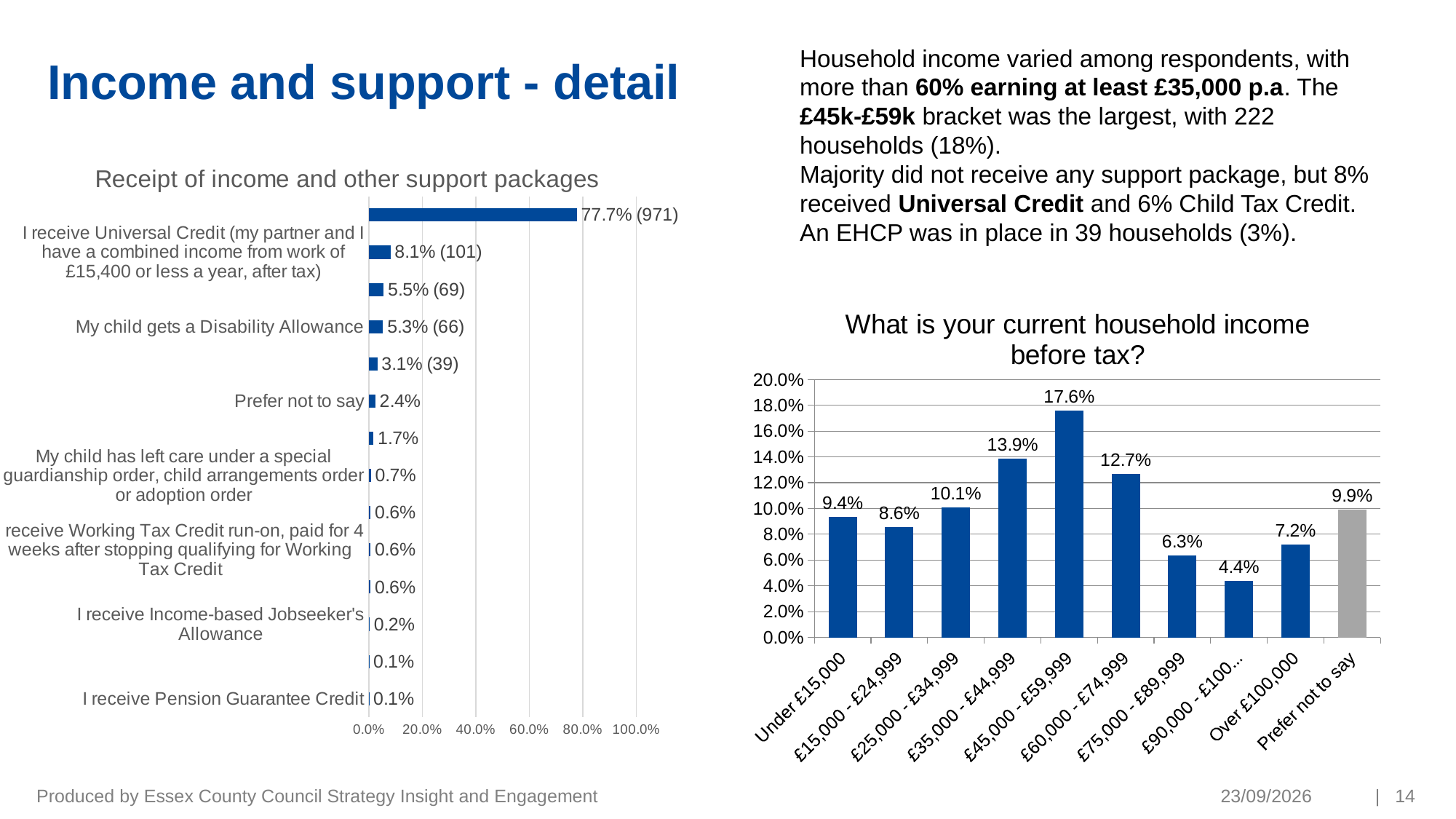
In the 'Receipt of income and other support packages' chart, what is the value for 'My child gets a Disability Allowance'? 5.3% (66) In the 'What is your current household income before tax?' chart, which income bracket has the highest value? £45,000 - £59,999 In the 'What is your current household income before tax?' chart, which category has the lowest value? £90,000 - £100... In the 'Receipt of income and other support packages' chart, what is the value for 'I receive Pension Guarantee Credit'? 0.1% In the 'Receipt of income and other support packages' chart, what is the value of the longest bar? 77.7% (971) How many income categories are shown in the 'What is your current household income before tax?' chart? 10 What type of chart is 'What is your current household income before tax?' Bar chart In the 'Receipt of income and other support packages' chart, is the value for 'Prefer not to say' greater or less than 20.0%? less In the 'What is your current household income before tax?' chart, what is the value for £45,000 - £59,999? 17.6% In the 'What is your current household income before tax?' chart, what is the value for Under £15,000? 9.4% In the 'What is your current household income before tax?' chart, which is larger: Over £100,000 or £75,000 - £89,999? Over £100,000 In the 'What is your current household income before tax?' chart, what is the difference between the values for £35,000 - £44,999 and £60,000 - £74,999? 1.2%